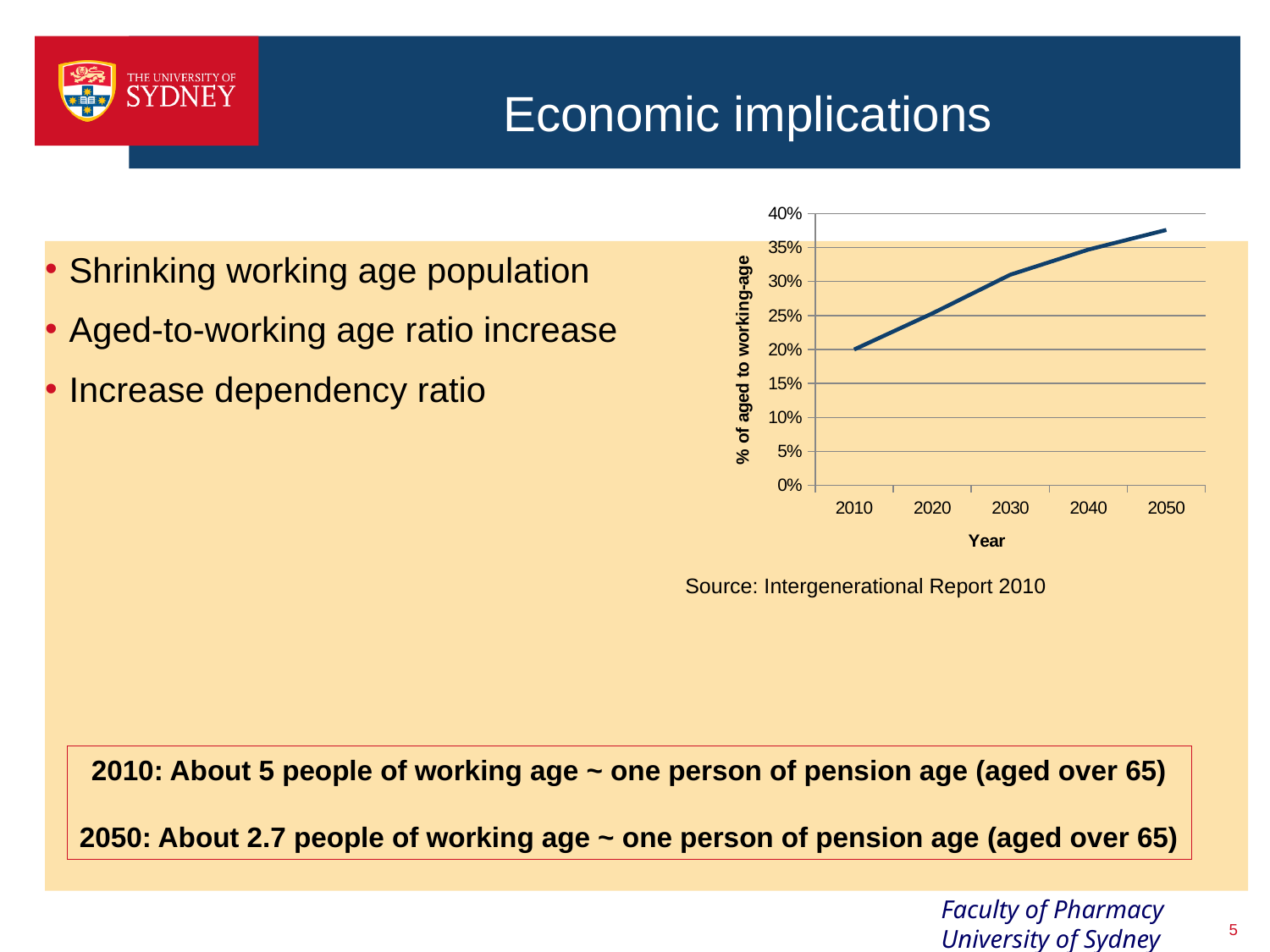
What is the title of the chart's y axis? % of aged to working-age Is the value for 2030 greater or less than 25%? greater How many years are marked along the x axis of the chart? 5 What source is cited below the chart? Intergenerational Report 2010 Which year has the lowest percentage of aged to working-age? 2010 Does the percentage of aged to working-age rise or fall from 2010 to 2050? rise What kind of chart is shown on the slide? line chart Is the value for 2010 greater or less than 15%? greater Which year has the highest percentage of aged to working-age? 2050 Which year has a larger percentage of aged to working-age, 2020 or 2040? 2040 Is the value for 2050 greater or less than 35%? greater